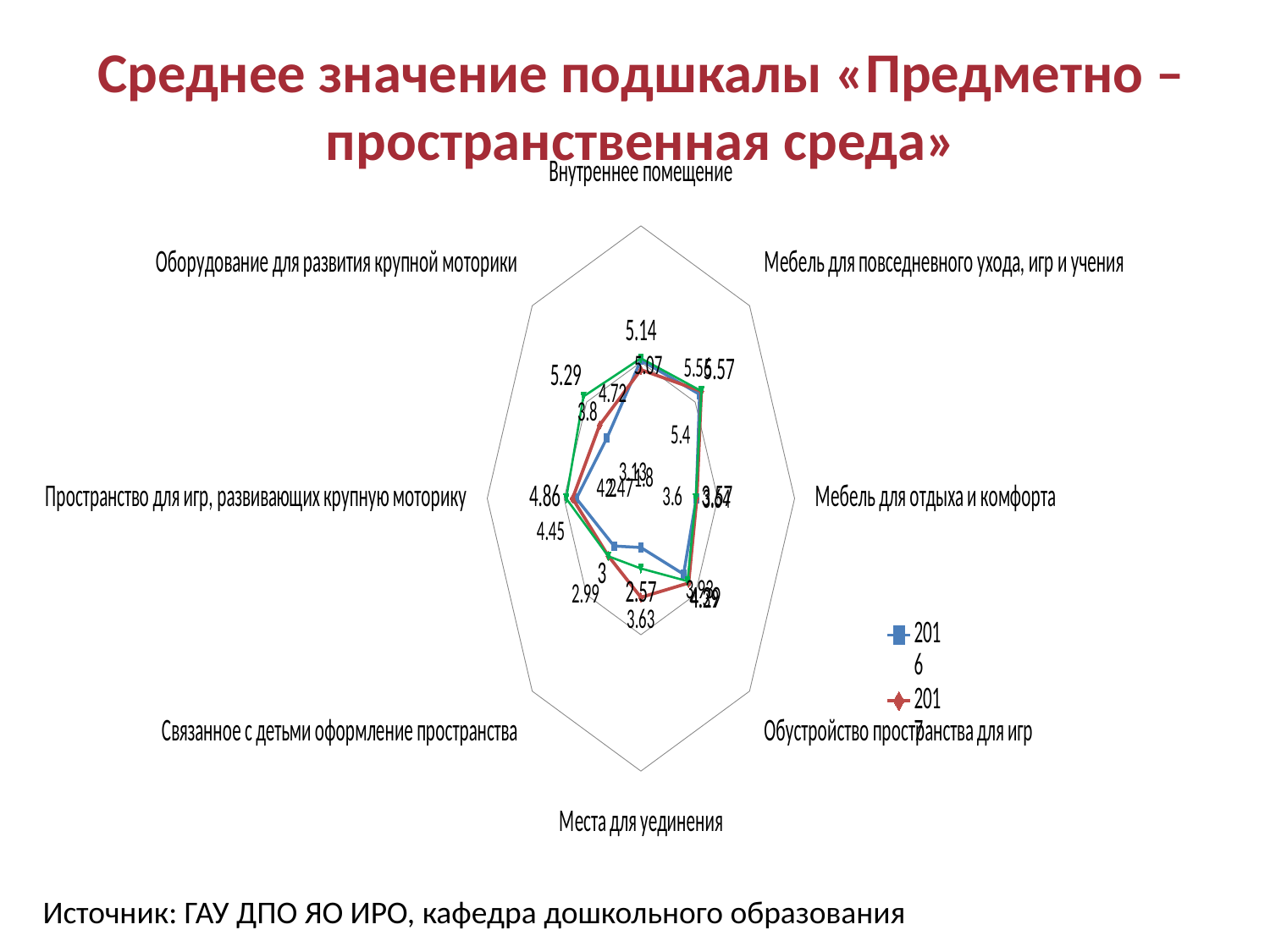
What is the largest value labelled for Мебель для повседневного ухода, игр и учения? 5.57 What is the title of the slide containing the chart? Среднее значение подшкалы «Предметно – пространственная среда» Which category has the highest values on the radar chart? Мебель для повседневного ухода, игр и учения What is the largest value labelled for Пространство для игр, развивающих крупную моторику? 4.86 Which colour represents the 2016 series in the legend? Blue What is the largest value labelled for Внутреннее помещение? 5.14 Which is larger: the top value for Мебель для повседневного ухода, игр и учения (5.57) or the top value for Внутреннее помещение (5.14)? Мебель для повседневного ухода, игр и учения What is the smallest value labelled for Оборудование для развития крупной моторики? 3.13 What kind of chart is shown on the slide? Radar chart How many categories (axes) does the radar chart have? 8 What is the largest value labelled for Оборудование для развития крупной моторики? 5.29